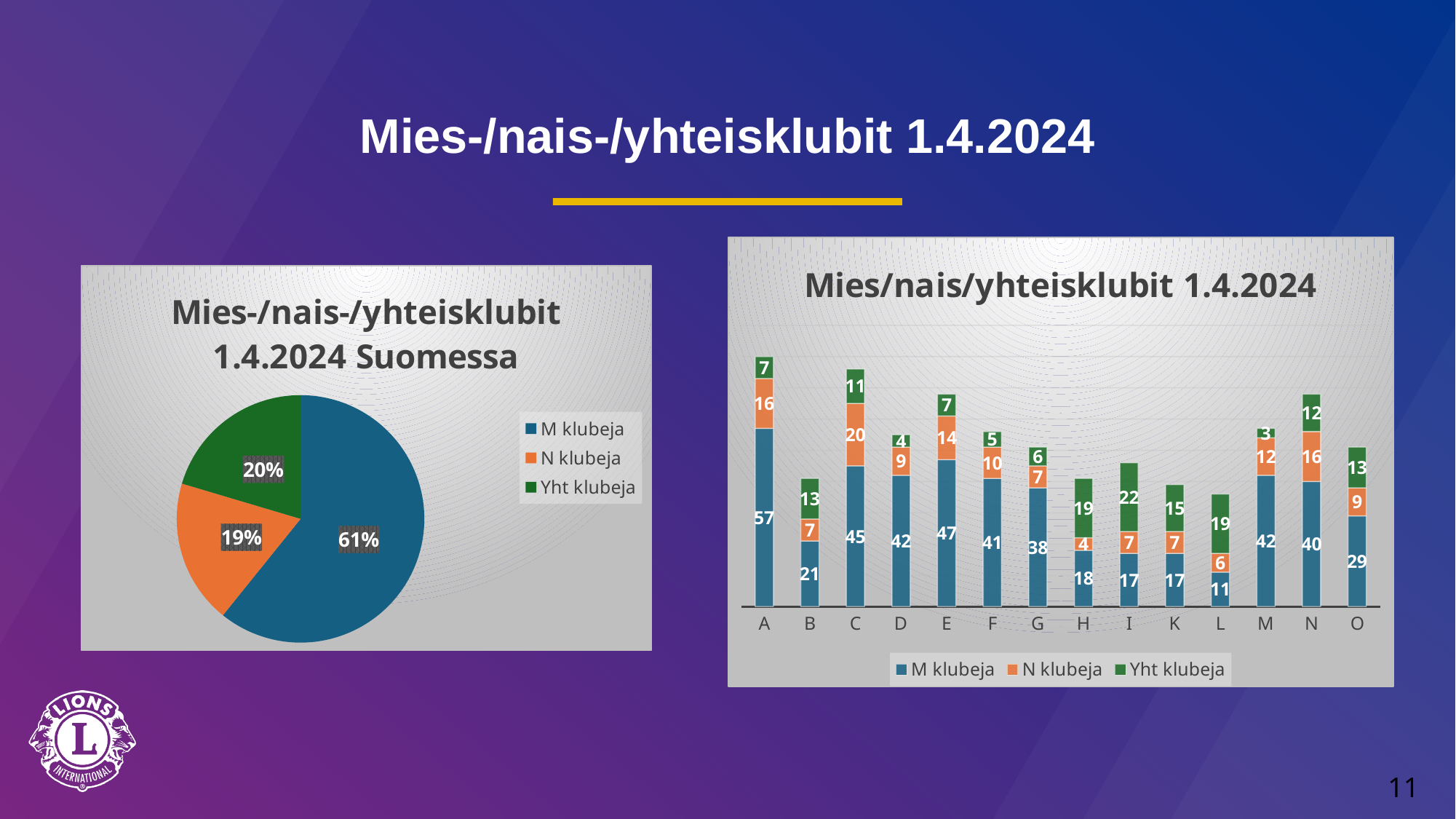
In the bar chart 'Mies/nais/yhteisklubit 1.4.2024', what is the difference between the M klubeja values for categories E and G? 9 In the pie chart 'Mies-/nais-/yhteisklubit 1.4.2024 Suomessa', what share is shown for M klubeja? 61% In the bar chart 'Mies/nais/yhteisklubit 1.4.2024', what is the value of N klubeja for category C? 20 In the bar chart 'Mies/nais/yhteisklubit 1.4.2024', what is the value of M klubeja for category A? 57 In the pie chart 'Mies-/nais-/yhteisklubit 1.4.2024 Suomessa', which category has the smallest slice? N klubeja What kind of chart is the chart titled 'Mies/nais/yhteisklubit 1.4.2024' on the right? Stacked bar chart In the pie chart 'Mies-/nais-/yhteisklubit 1.4.2024 Suomessa', what share is shown for N klubeja? 19% How many series does the legend of the pie chart 'Mies-/nais-/yhteisklubit 1.4.2024 Suomessa' list? 3 In the bar chart 'Mies/nais/yhteisklubit 1.4.2024', what is the total of the stacked bar for category B? 41 How many categories are shown on the x axis of the bar chart 'Mies/nais/yhteisklubit 1.4.2024'? 14 In the bar chart 'Mies/nais/yhteisklubit 1.4.2024', which category has the highest M klubeja value? A In the bar chart 'Mies/nais/yhteisklubit 1.4.2024', what is the value of Yht klubeja for category I? 22